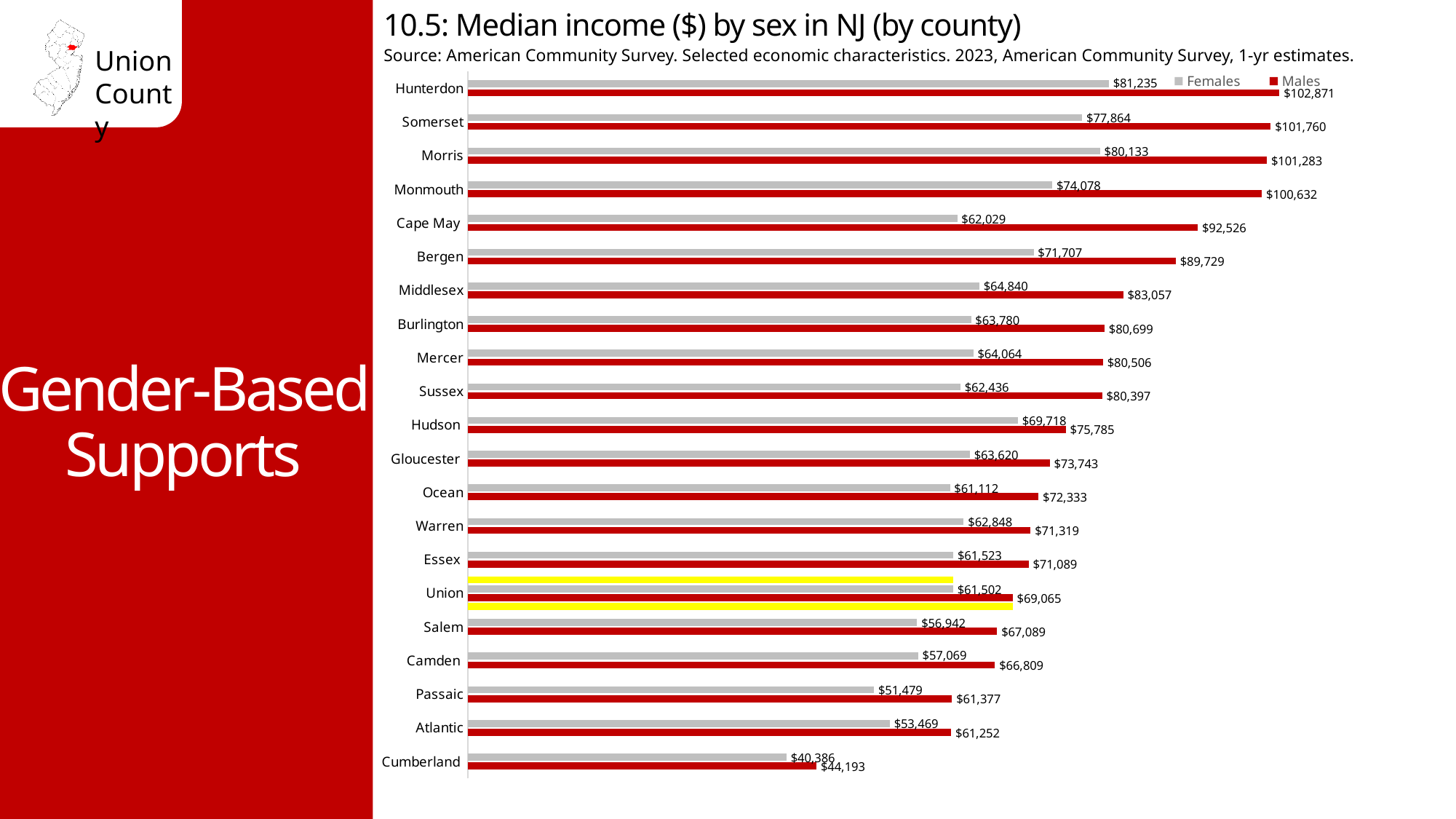
What is the difference between the male and female median incomes in Hunterdon County? $21,636 What is the median income for females in Cumberland County? $40,386 Which county has the lowest median income for females? Cumberland How many counties are shown in the chart? 21 What is the median income for females in Hunterdon County? $81,235 What is the difference between the male and female median incomes in Union County? $7,563 What is the median income for males in Cape May County? $92,526 What is the median income for males in Union County? $69,065 How many series does the legend list? 2 Which county has the highest median income for males? Hunterdon Which is larger: the female median income in Hudson County or the female median income in Bergen County? Bergen County What type of chart is shown on the slide? Bar chart